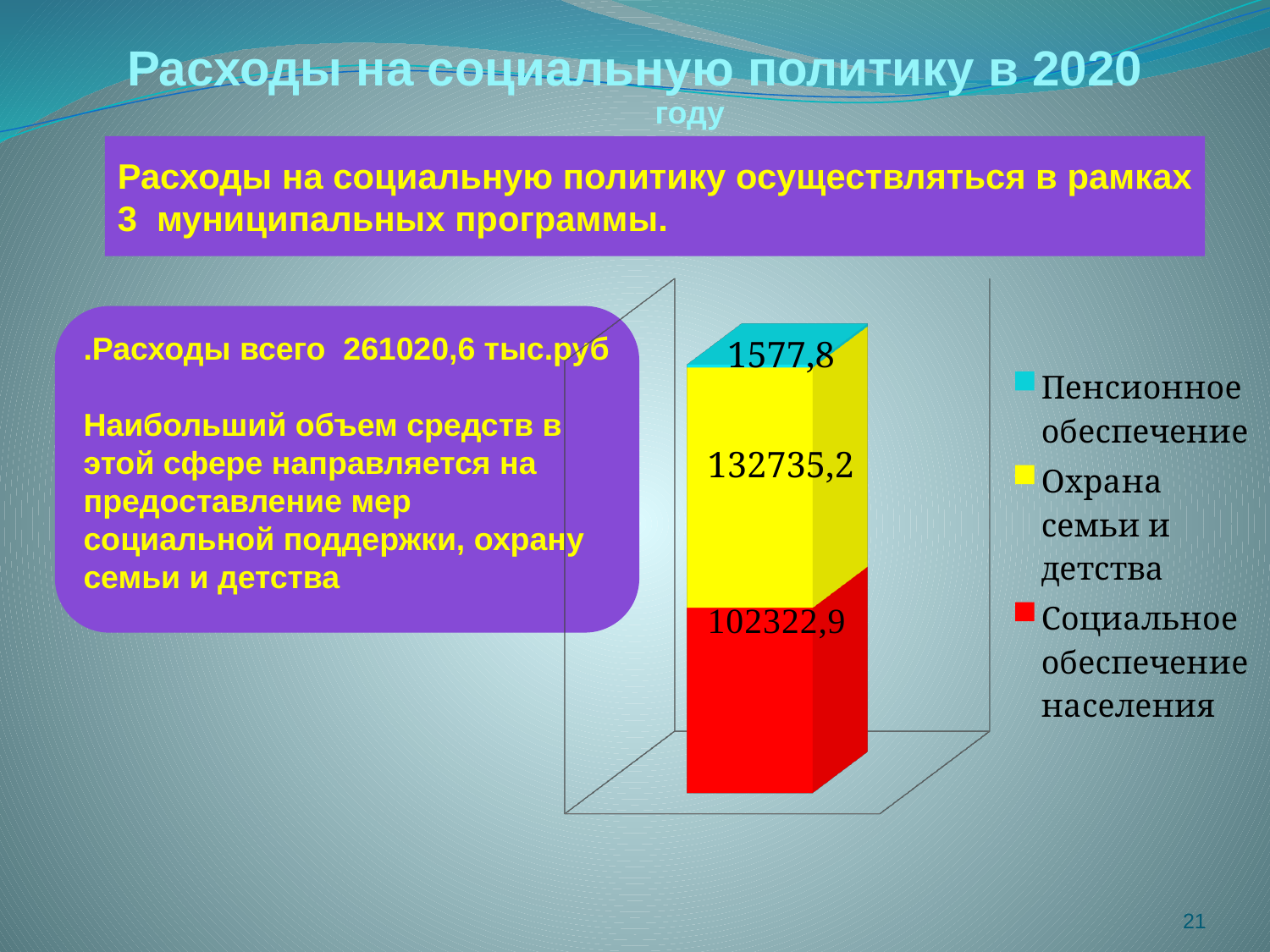
What is the value for Охрана семьи и детства in the chart? 132735,2 What is the difference between the values for Охрана семьи и детства and Социальное обеспечение населения? 30412,3 What is the value for Пенсионное обеспечение in the chart? 1577,8 What is the value for Социальное обеспечение населения in the chart? 102322,9 How many bars are plotted in the chart? 1 Which series has the lowest value in the chart? Пенсионное обеспечение Which is larger: the value for Социальное обеспечение населения or the value for Пенсионное обеспечение? Социальное обеспечение населения What is the total of the stacked bar in the chart? 236635,9 Which series has the highest value in the chart? Охрана семьи и детства What kind of chart is shown on the slide? Stacked bar chart Which colour represents Социальное обеспечение населения in the chart legend? Red How many series does the legend list? 3